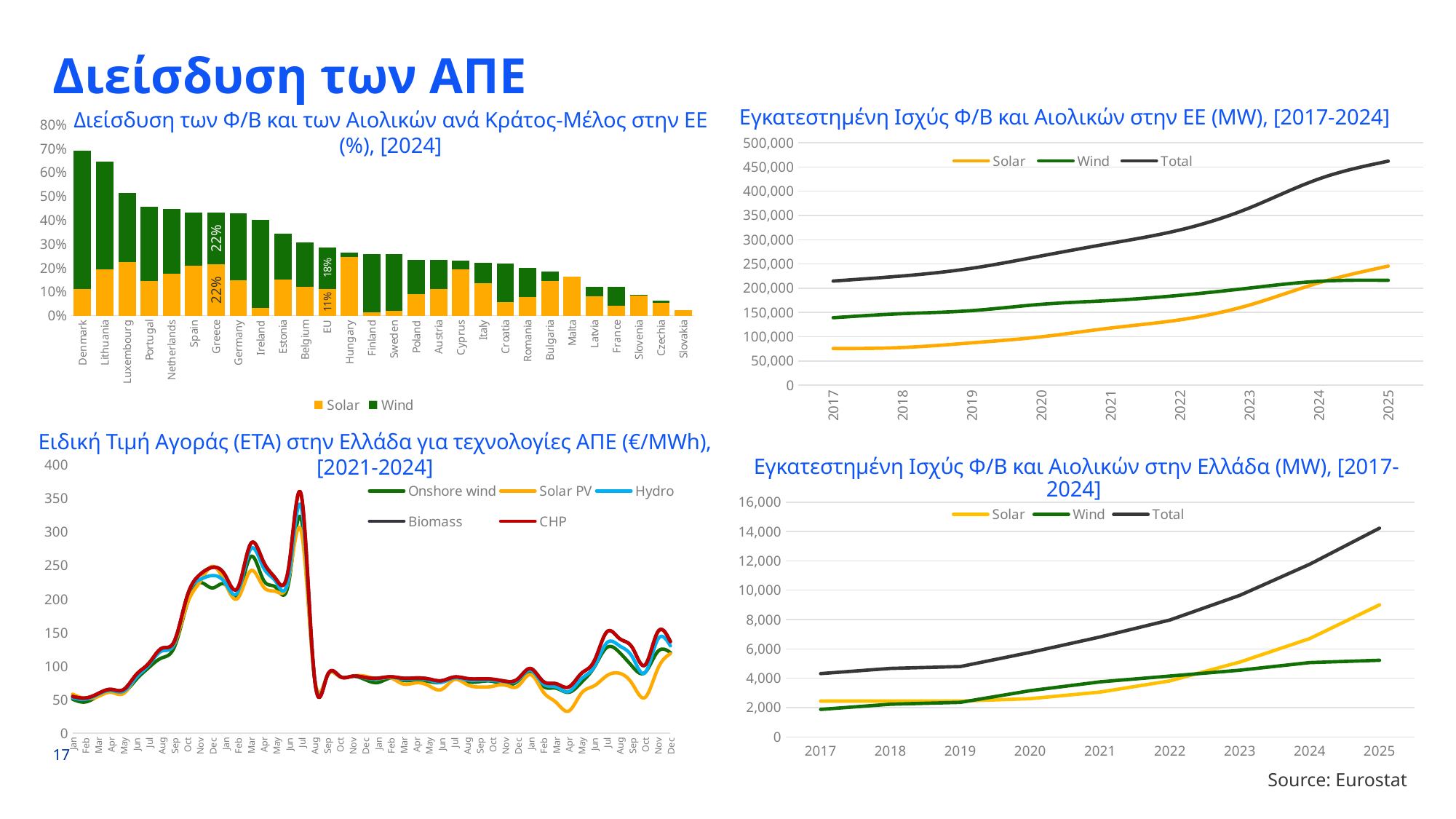
In the bottom-right chart on installed solar and wind capacity in Greece (MW), does the Total line rise or fall from 2017 to 2025? Rises In the top-left chart on solar and wind penetration by EU member state, what is the Solar value for Greece? 22% In the top-left chart on solar and wind penetration by EU member state, which country has the lowest combined bar? Slovakia In the bottom-right chart on installed solar and wind capacity in Greece (MW), is the Wind value for 2025 greater or less than 6,000? less In the top-left chart on solar and wind penetration by EU member state, what is the combined Solar plus Wind total for Greece? 44% How many series does the legend list in the bottom-left chart on the special market price (ΕΤΑ) in Greece? 5 In the top-left chart on solar and wind penetration by EU member state, what is the combined Solar plus Wind total for the EU? 29% In the top-left chart on solar and wind penetration by EU member state, how much higher is Greece's Solar value than the EU's Solar value? 11% What kind of chart is the top-left chart on solar and wind penetration by EU member state? Bar chart In the top-left chart on solar and wind penetration by EU member state, what is the Wind value for the EU? 18% In the top-left chart on solar and wind penetration by EU member state, which country has the highest combined bar? Denmark In the top-right chart on installed solar and wind capacity in the EU (MW), is the Total value for 2025 greater or less than 450,000? greater